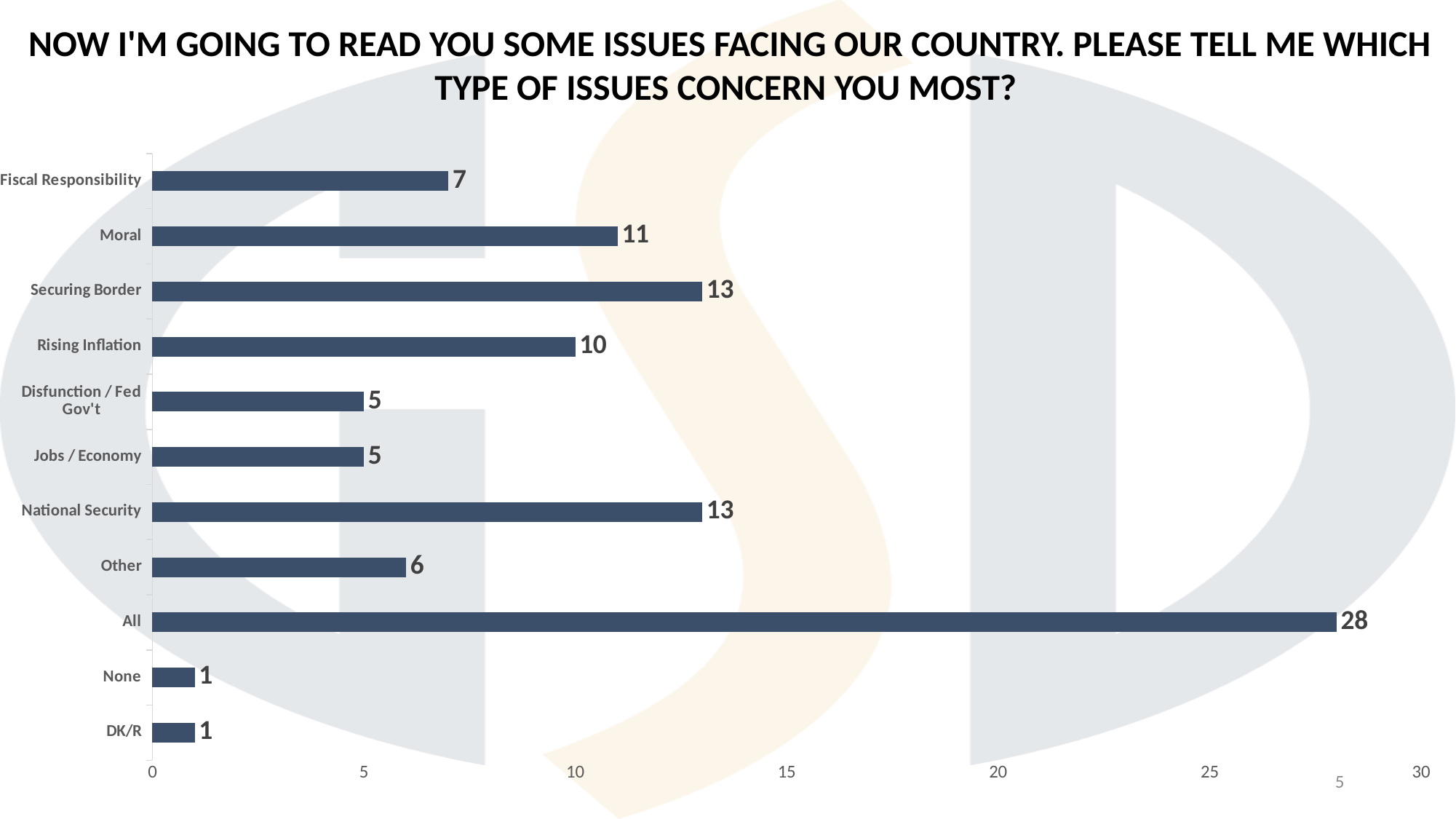
What kind of chart is shown on the slide? bar chart Is the value for All greater or less than 25? greater What is the difference between the values for Moral and Fiscal Responsibility? 4 How many categories are shown on the chart? 11 What is the value for Rising Inflation? 10 Which is larger, the value for Rising Inflation or the value for Other? Rising Inflation What is the value for None? 1 What is the value for Securing Border? 13 What is the value for Moral? 11 Which category has the highest value? All What is the difference between the values for All and Securing Border? 15 What is the value for Jobs / Economy? 5